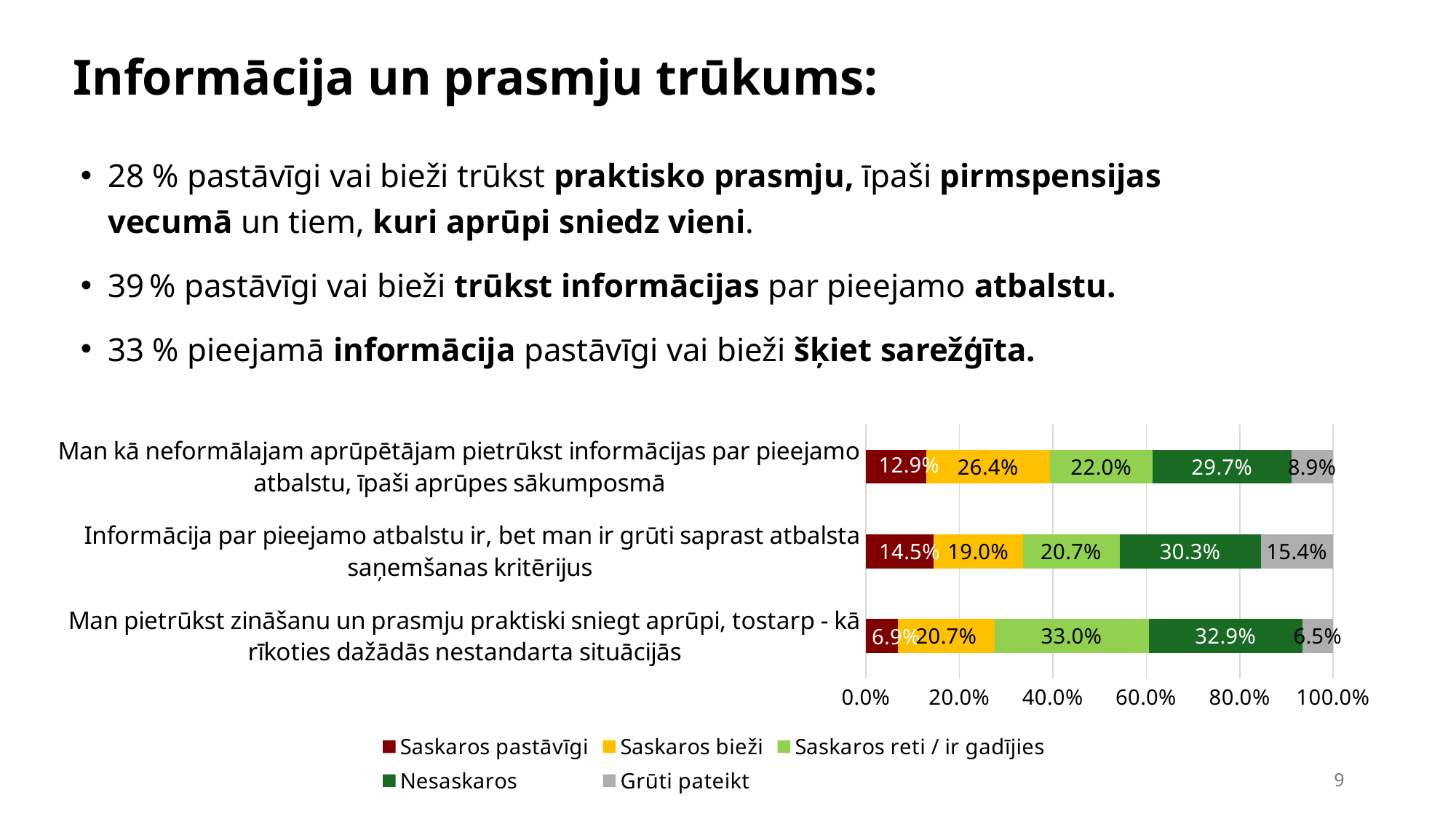
What is the difference between the "Saskaros bieži" values for "Man kā neformālajam aprūpētājam pietrūkst informācijas par pieejamo atbalstu, īpaši aprūpes sākumposmā" and "Informācija par pieejamo atbalstu ir, bet man ir grūti saprast atbalsta saņemšanas kritērijus"? 7.4% What is the value of "Saskaros reti / ir gadījies" for the category "Man pietrūkst zināšanu un prasmju praktiski sniegt aprūpi, tostarp - kā rīkoties dažādās nestandarta situācijās"? 33.0% Which category has the lowest value for "Saskaros pastāvīgi"? Man pietrūkst zināšanu un prasmju praktiski sniegt aprūpi, tostarp - kā rīkoties dažādās nestandarta situācijās Which is larger: the "Saskaros reti / ir gadījies" value for "Man kā neformālajam aprūpētājam pietrūkst informācijas par pieejamo atbalstu, īpaši aprūpes sākumposmā" or for "Informācija par pieejamo atbalstu ir, bet man ir grūti saprast atbalsta saņemšanas kritērijus"? Man kā neformālajam aprūpētājam pietrūkst informācijas par pieejamo atbalstu, īpaši aprūpes sākumposmā What is the value of "Saskaros pastāvīgi" for the category "Informācija par pieejamo atbalstu ir, bet man ir grūti saprast atbalsta saņemšanas kritērijus"? 14.5% What is the total of the stacked bar for "Man pietrūkst zināšanu un prasmju praktiski sniegt aprūpi, tostarp - kā rīkoties dažādās nestandarta situācijās"? 100.0% What kind of chart is shown on the slide? stacked bar chart Which category has the highest value for "Grūti pateikt"? Informācija par pieejamo atbalstu ir, bet man ir grūti saprast atbalsta saņemšanas kritērijus Which legend entry is shown in dark red? Saskaros pastāvīgi How many series does the chart legend list? 5 How many categories (bars) does the chart show? 3 What is the value of "Nesaskaros" for the category "Man kā neformālajam aprūpētājam pietrūkst informācijas par pieejamo atbalstu, īpaši aprūpes sākumposmā"? 29.7%